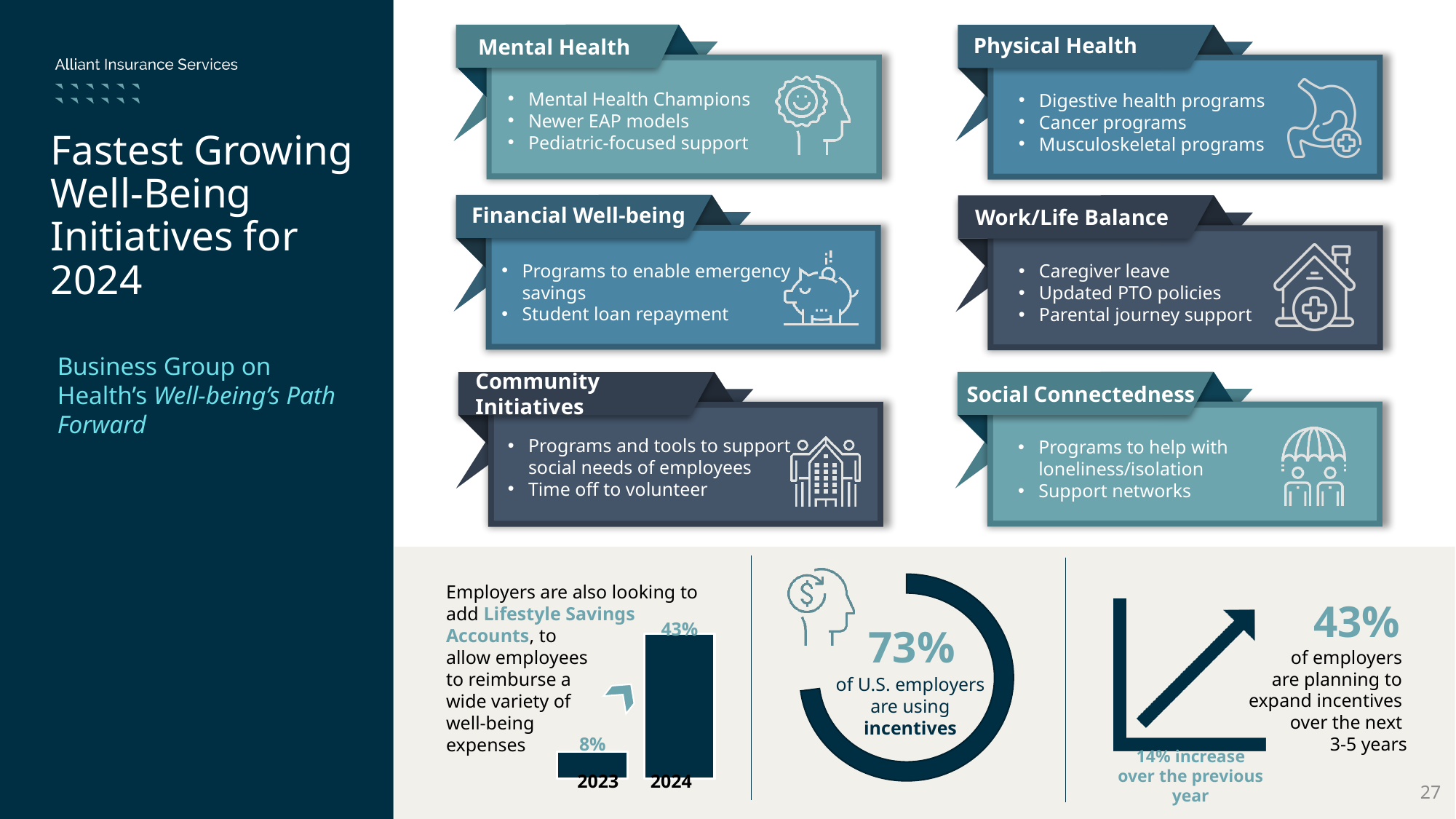
What kind of chart is used to show the Lifestyle Savings Accounts data for 2023 and 2024? bar chart In the Lifestyle Savings Accounts bar chart, do the values rise or fall from 2023 to 2024? rise What colour are the bars in the Lifestyle Savings Accounts bar chart? dark teal In the Lifestyle Savings Accounts bar chart, what is the value for 2024? 43% In the Lifestyle Savings Accounts bar chart, is the value for 2024 larger or smaller than the value for 2023? larger Which years are labelled on the x axis of the Lifestyle Savings Accounts bar chart? 2023 and 2024 In the Lifestyle Savings Accounts bar chart, which year has the higher value? 2024 In the Lifestyle Savings Accounts bar chart, which year has the lower value? 2023 What percentage of U.S. employers are using incentives, according to the circular graphic at the bottom of the slide? 73% In the Lifestyle Savings Accounts bar chart, what is the difference between the 2024 and 2023 values? 35 percentage points In the Lifestyle Savings Accounts bar chart, what is the value for 2023? 8% How many bars are shown in the Lifestyle Savings Accounts bar chart? 2